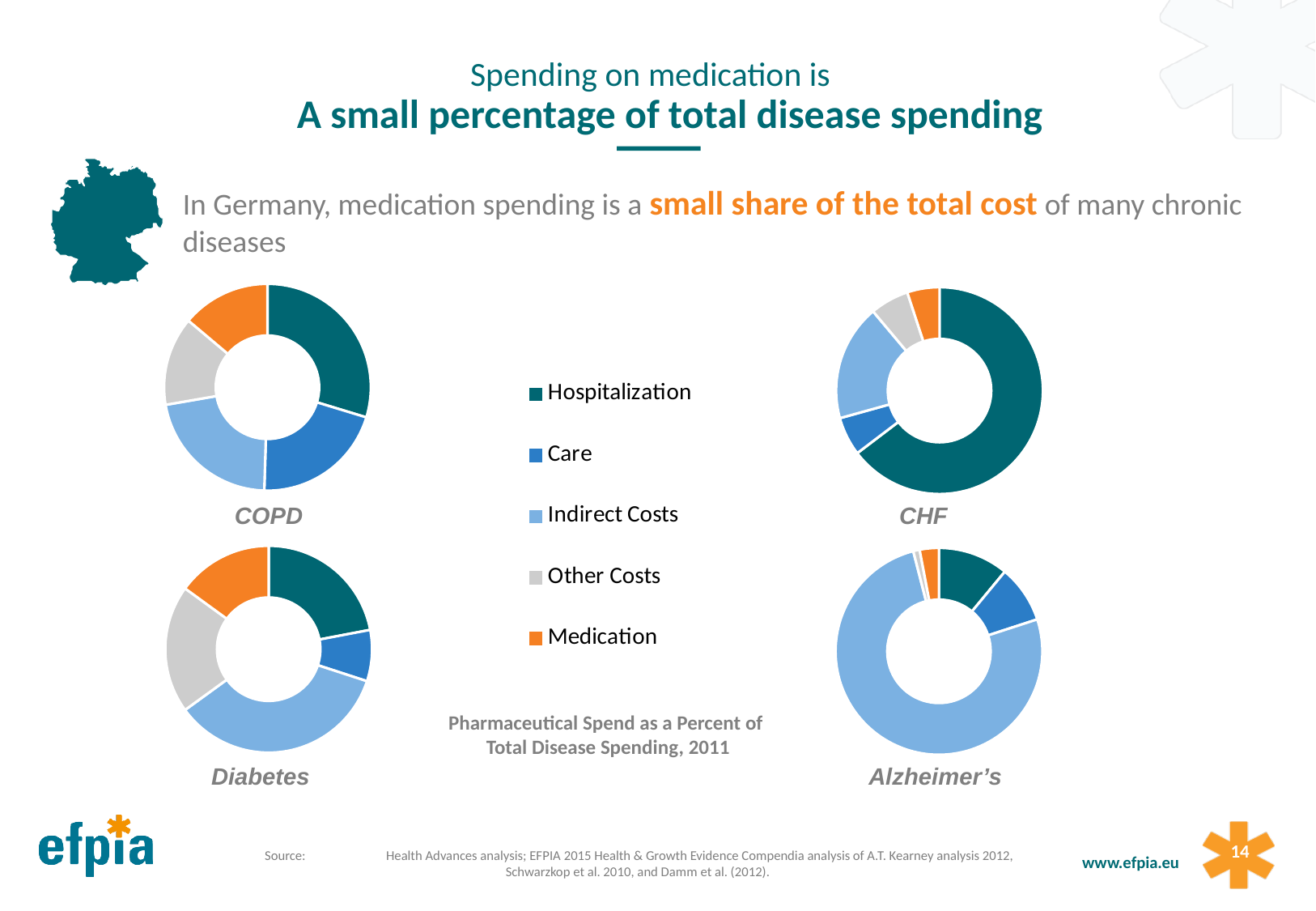
What is the caption printed in the centre of the slide beneath the legend? Pharmaceutical Spend as a Percent of Total Disease Spending, 2011 In the CHF chart, which is larger: Hospitalization or Indirect Costs? Hospitalization How many categories does the legend list? 5 In the Diabetes chart, which category has the largest share? Indirect Costs In the Alzheimer's chart, which category has the largest share? Indirect Costs In the Diabetes chart, which is larger: Care or Indirect Costs? Indirect Costs How many donut charts are shown on the slide? 4 In the CHF chart, which category has the largest share? Hospitalization In the Alzheimer's chart, which category has the smallest share? Other Costs Which colour represents Medication in the legend? Orange What kind of chart is used to show the spending breakdown for COPD? Pie chart (donut)